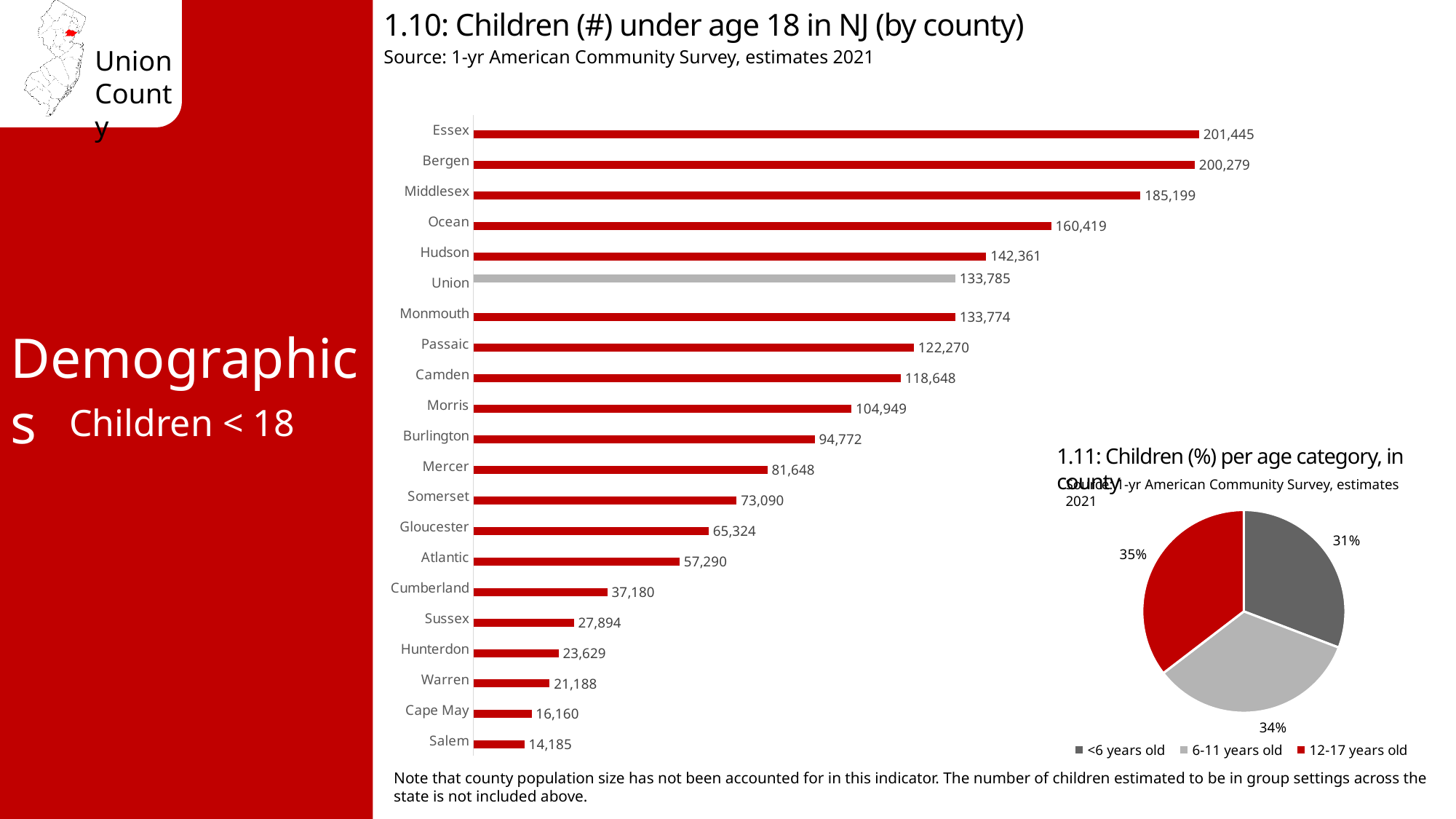
In chart 1.10, which has more children under 18, Passaic or Camden? Passaic In chart 1.10, which county has the lowest number of children under 18? Salem In chart 1.10, which county has the highest number of children under 18? Essex In chart 1.10, what is the value for Ocean County? 160,419 What kind of chart is chart 1.10? Bar chart In chart 1.11, which age category has the largest share? 12-17 years old In chart 1.10, how many counties are shown? 21 In chart 1.11 (Children % per age category in Union County), what share of children are 6-11 years old? 34% In chart 1.10 (Children under age 18 in NJ by county), how many children under 18 are in Union County? 133,785 In chart 1.11, how many age categories does the legend list? 3 In chart 1.10, what is the difference between Essex and Bergen? 1,166 In chart 1.10, what is the difference between Hudson and Union? 8,576